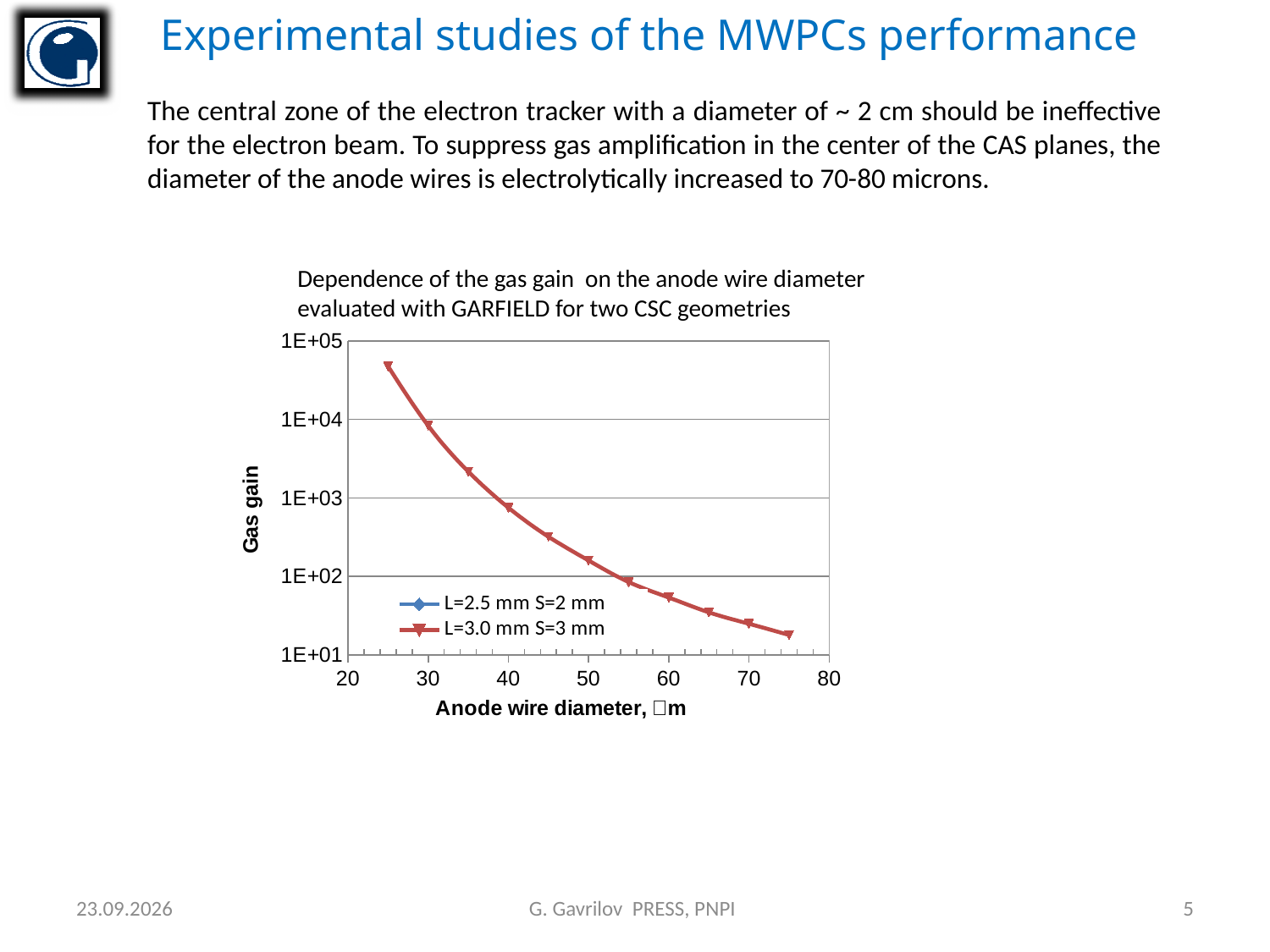
At which anode wire diameter is the gas gain highest? 25 Is the gas gain at an anode wire diameter of 65 greater or less than 1E+02? less Does the gas gain rise or fall as the anode wire diameter increases? fall Is the gas gain at an anode wire diameter of 25 greater or less than 1E+04? greater Which has the larger gas gain: an anode wire diameter of 35 or of 60? 35 How many data points are plotted for the L=3.0 mm S=3 mm series? 11 Is the gas gain at an anode wire diameter of 45 greater or less than 1E+03? less What are the two series named in the chart legend? L=2.5 mm S=2 mm and L=3.0 mm S=3 mm What is the label of the y axis of the chart? Gas gain How many series does the chart legend list? 2 What kind of chart is shown on the slide? line chart At which anode wire diameter is the gas gain lowest? 75